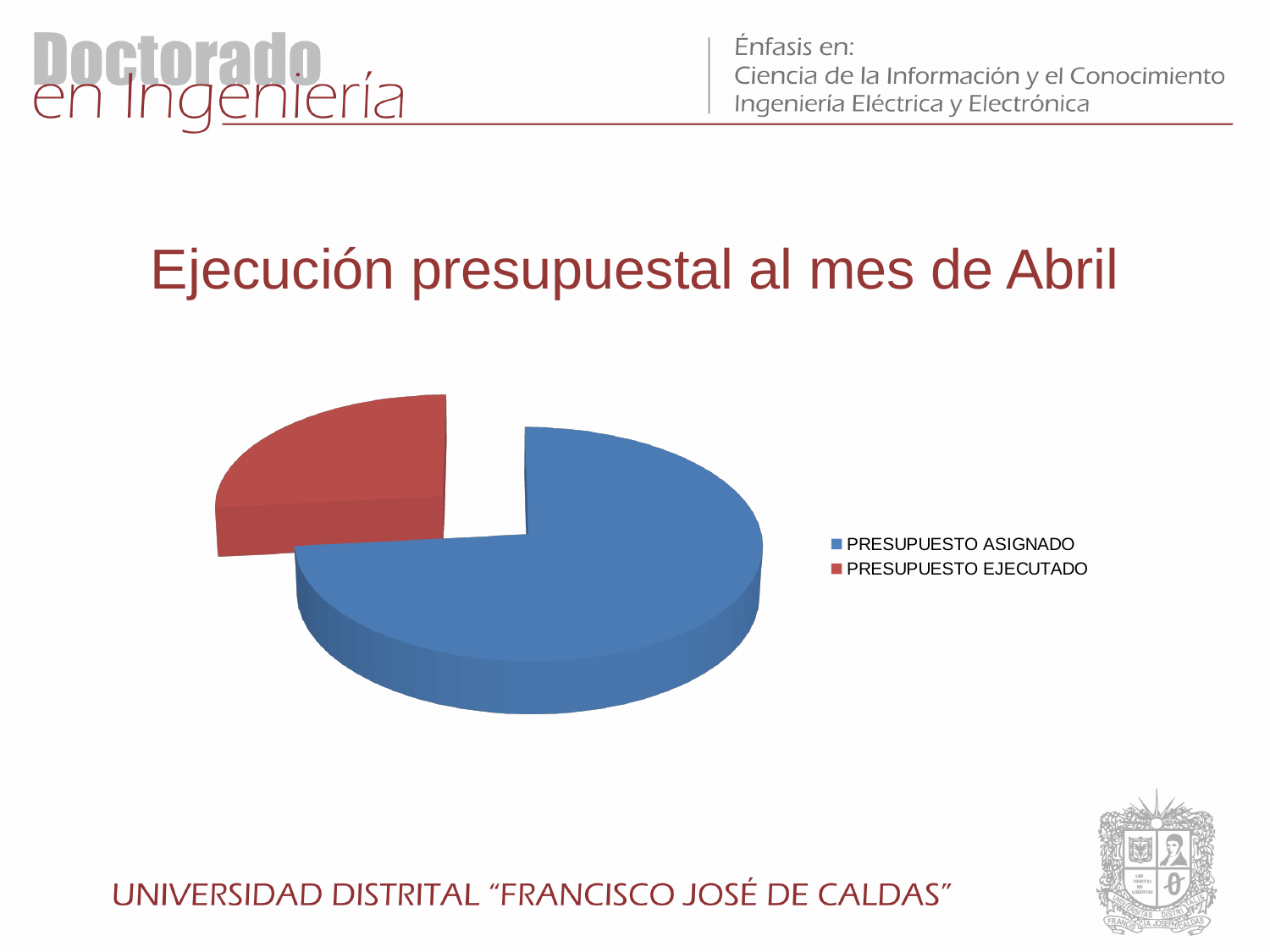
What colour is the PRESUPUESTO EJECUTADO slice in the pie chart? red What kind of chart is shown on the slide? pie chart How many slices does the pie chart have? 2 Which category has the largest slice of the pie chart? PRESUPUESTO ASIGNADO What is the title of the chart on the slide? Ejecución presupuestal al mes de Abril Which slice is larger, PRESUPUESTO ASIGNADO or PRESUPUESTO EJECUTADO? PRESUPUESTO ASIGNADO Which category has the smallest slice of the pie chart? PRESUPUESTO EJECUTADO How many entries does the legend of the pie chart list? 2